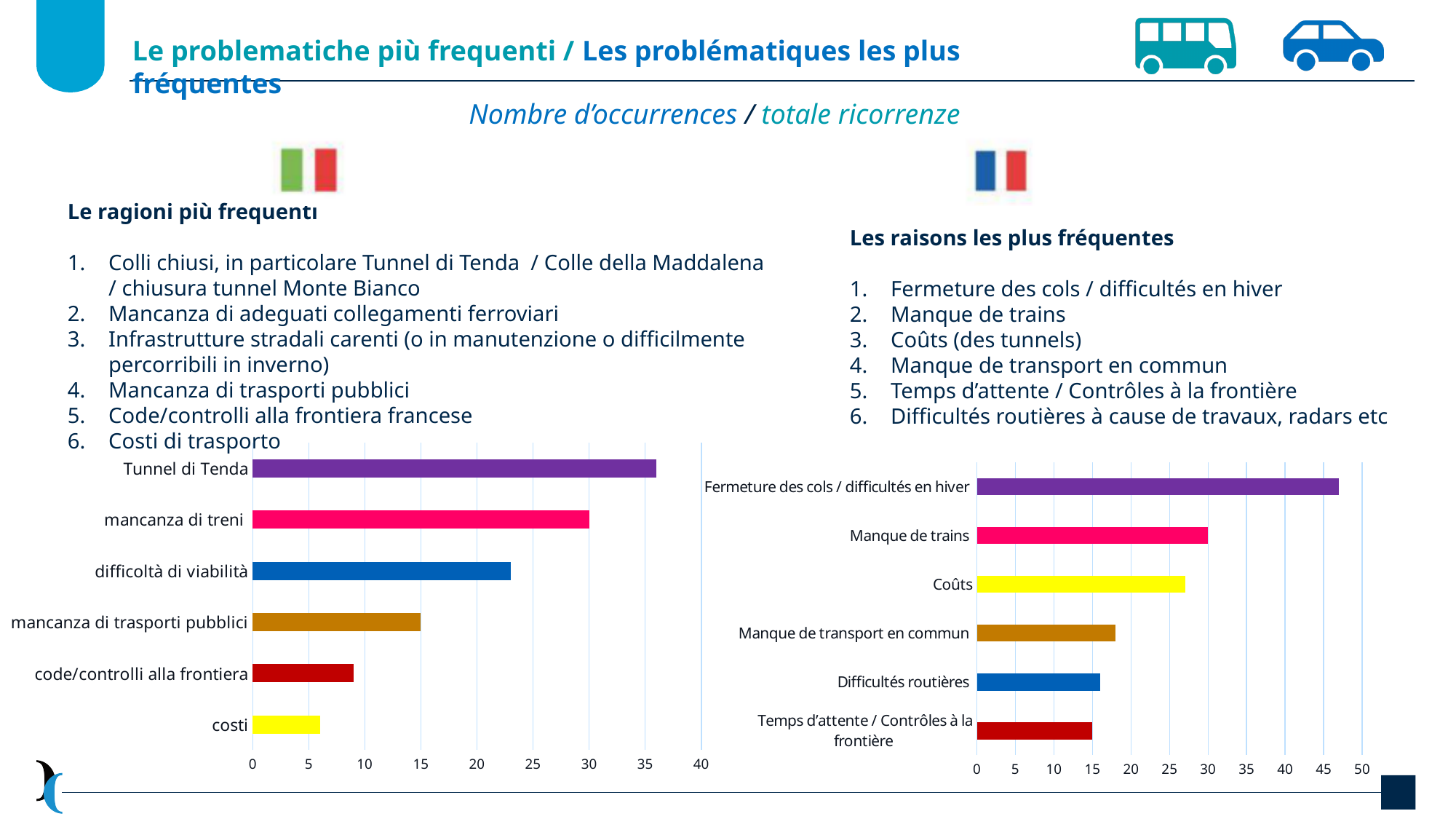
On the left chart, which category has the highest value? Tunnel di Tenda On the left chart, how many categories are plotted? 6 What kind of chart is the left chart? bar chart On the right chart, how many categories are plotted? 6 On the right chart, is the value for Coûts greater or less than 25? greater On the left chart, is the value for Tunnel di Tenda greater or less than 35? greater On the left chart, which category has the lowest value? costi On the right chart, is the value for Fermeture des cols / difficultés en hiver greater or less than 45? greater On the right chart, which category has the highest value? Fermeture des cols / difficultés en hiver On the right chart, which is larger, Manque de trains or Manque de transport en commun? Manque de trains